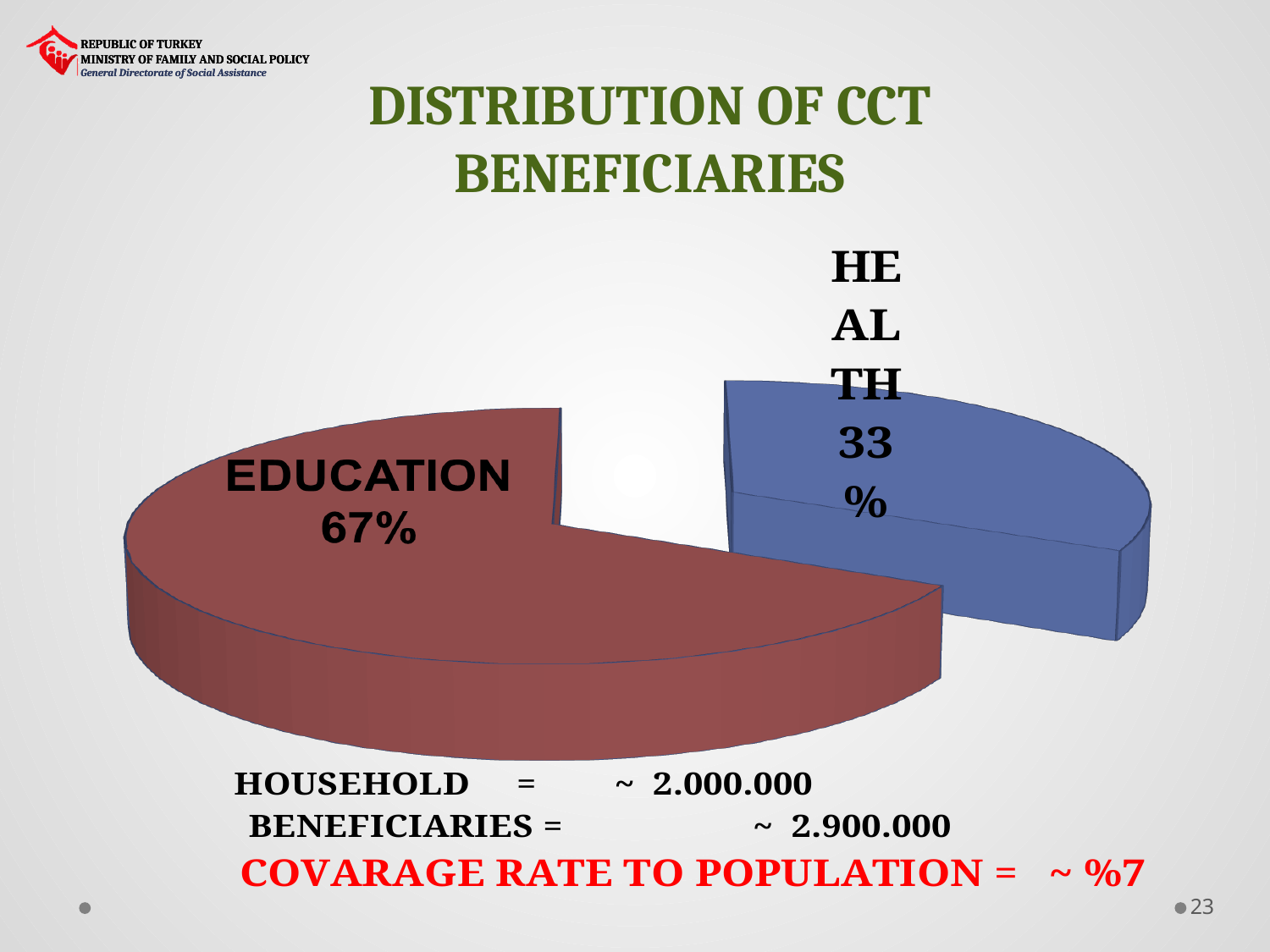
What share of CCT beneficiaries is shown for HEALTH? 33% What is the difference in percentage points between the EDUCATION and HEALTH slices? 34 Which slice of the pie is the smallest? HEALTH What share of CCT beneficiaries is shown for EDUCATION? 67% Is the share for HEALTH greater or less than 50%? less What kind of chart is shown on the slide? pie chart Which is larger, the EDUCATION slice or the HEALTH slice? EDUCATION What colour is the EDUCATION slice of the pie? red How many slices does the pie chart have? 2 What is the title of the chart on the slide? DISTRIBUTION OF CCT BENEFICIARIES Which slice of the pie is the largest? EDUCATION